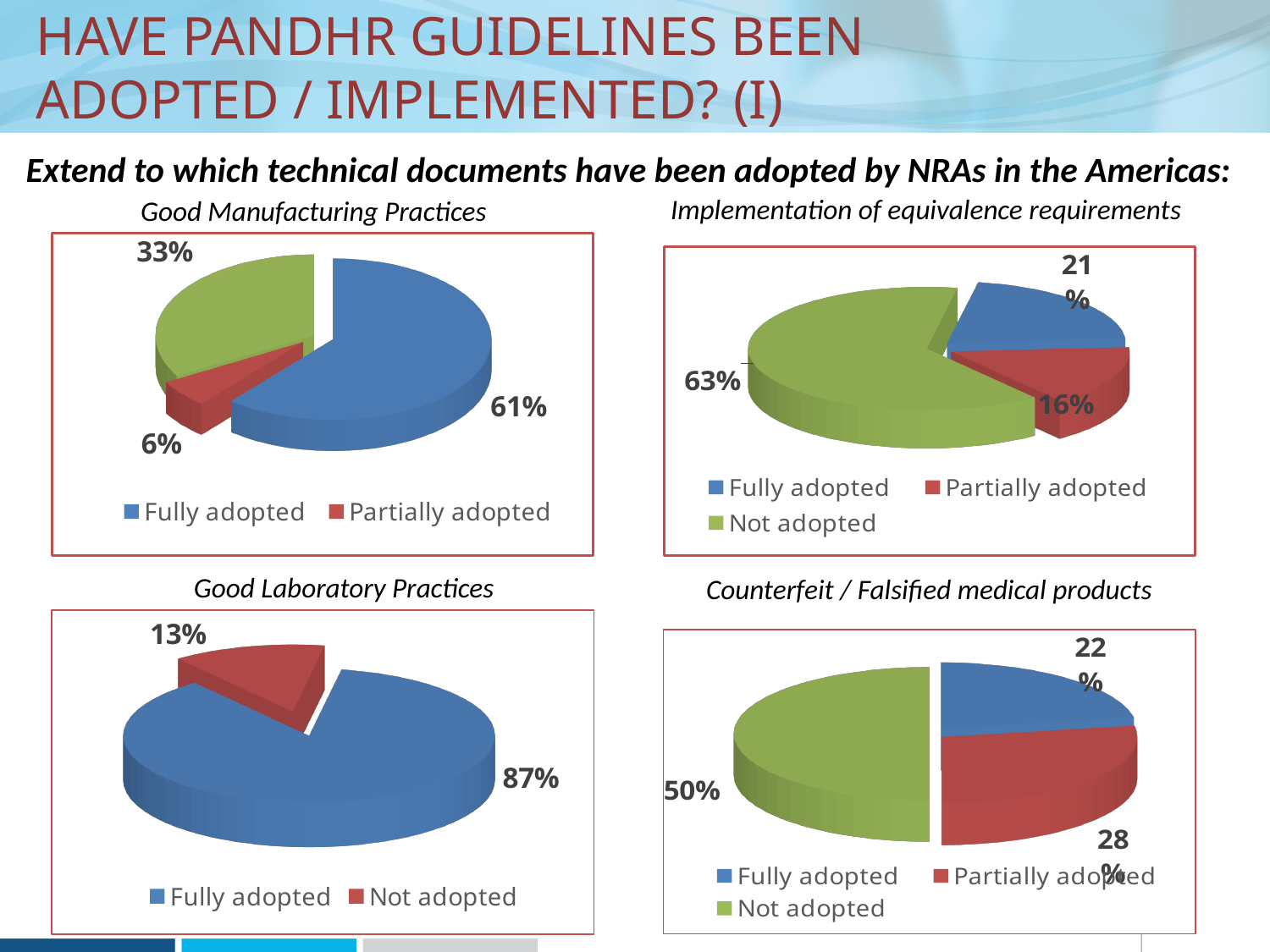
In the Implementation of equivalence requirements chart, what share is Fully adopted? 21% In the Good Manufacturing Practices chart, what share is Partially adopted? 6% How many charts are shown on the slide? 4 In the Good Laboratory Practices chart, what is the difference between Fully adopted and Not adopted? 74% In the Counterfeit / Falsified medical products chart, what share is Not adopted? 50% In the Implementation of equivalence requirements chart, which category has the smallest slice? Partially adopted In the Good Manufacturing Practices chart, what share is Fully adopted? 61% In the Implementation of equivalence requirements chart, what share is Not adopted? 63% In the Good Laboratory Practices chart, what share is Fully adopted? 87% In the Counterfeit / Falsified medical products chart, how many categories does the legend list? 3 What type of chart is the Good Laboratory Practices chart? Pie chart In the Counterfeit / Falsified medical products chart, which is larger, Fully adopted or Partially adopted? Partially adopted